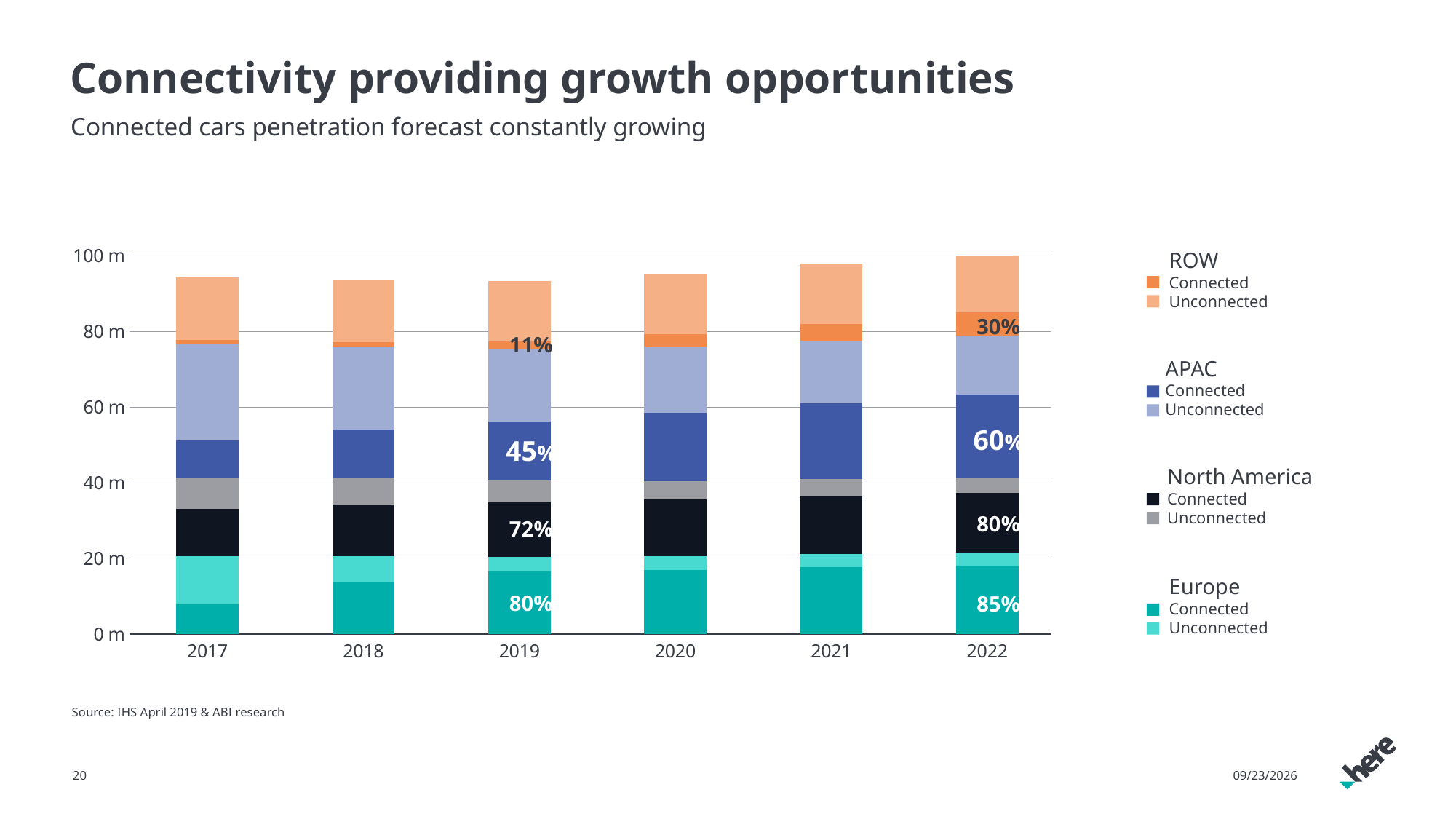
What percentage is labelled on the APAC Connected segment for 2022? 60% Is the total height of the 2017 stacked bar greater or less than 100 m? less How many series does the chart's legend list in total? 8 What kind of chart is shown on the slide? Stacked bar chart Is the Europe Connected segment for 2017 greater or less than 20 m? less By how many percentage points does the labelled APAC connected share rise from 2019 to 2022? 15 percentage points How many years are shown along the x axis of the chart? 6 In 2022, which region has the higher labelled connected share: Europe or North America? Europe What percentage is labelled for ROW in 2019? 11% What is the title of the slide containing the chart? Connectivity providing growth opportunities What connected-car penetration percentage is labelled for Europe in 2019? 80% What percentage is labelled on the North America Connected segment for 2022? 80%